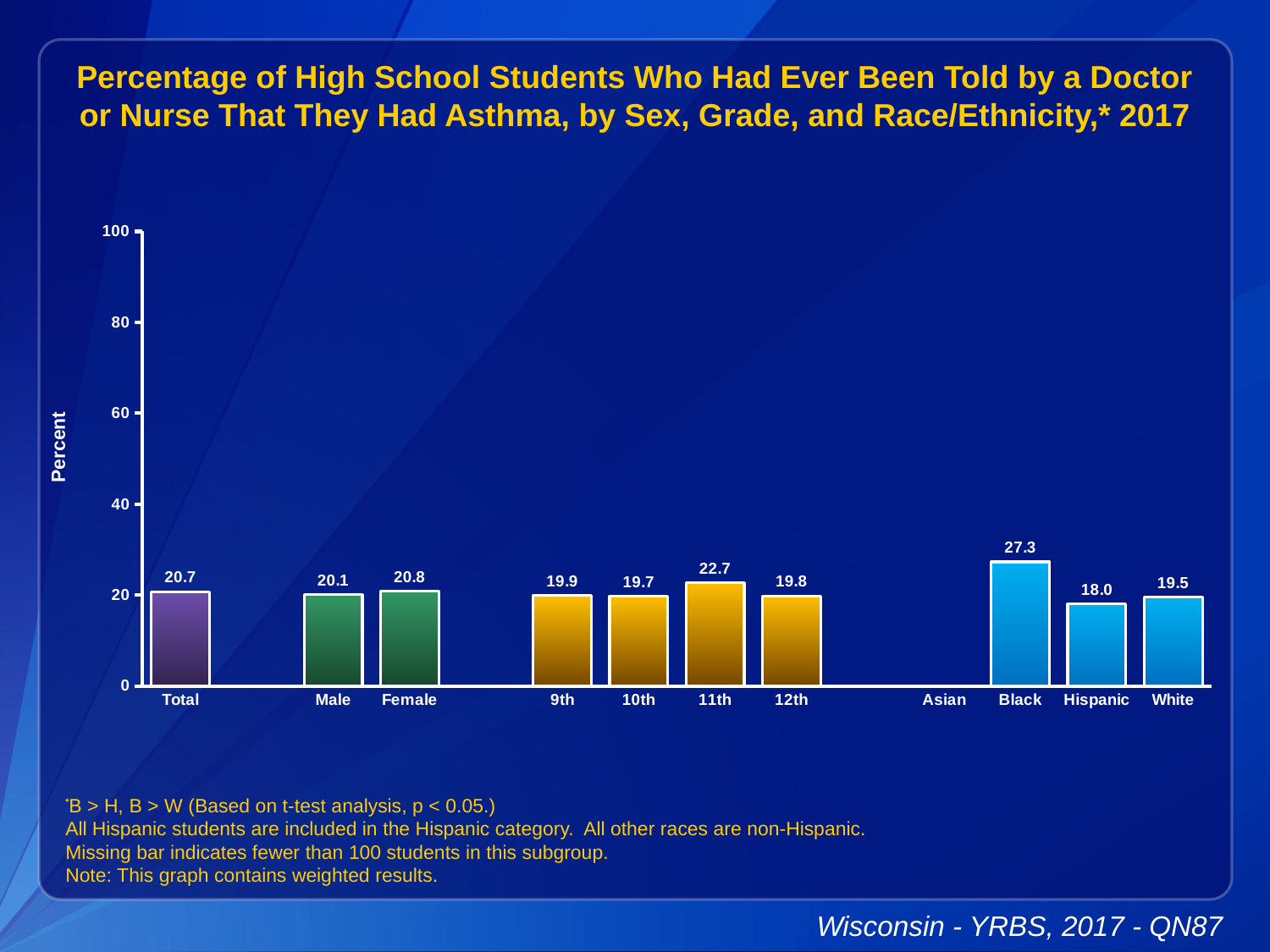
What is the value for Total? 20.7 Which category has the lowest value among the bars shown? Hispanic What is the value for 11th grade? 22.7 What kind of chart is shown? bar chart Which category has the highest value? Black How many bars are plotted on the chart? 11 What is the difference between the values for Black and White? 7.8 Which category label has no bar plotted? Asian Which is larger, the value for Male or the value for Female? Female What is the value for Female? 20.8 Is the value for Black greater or less than 40? less What is the value for Hispanic? 18.0